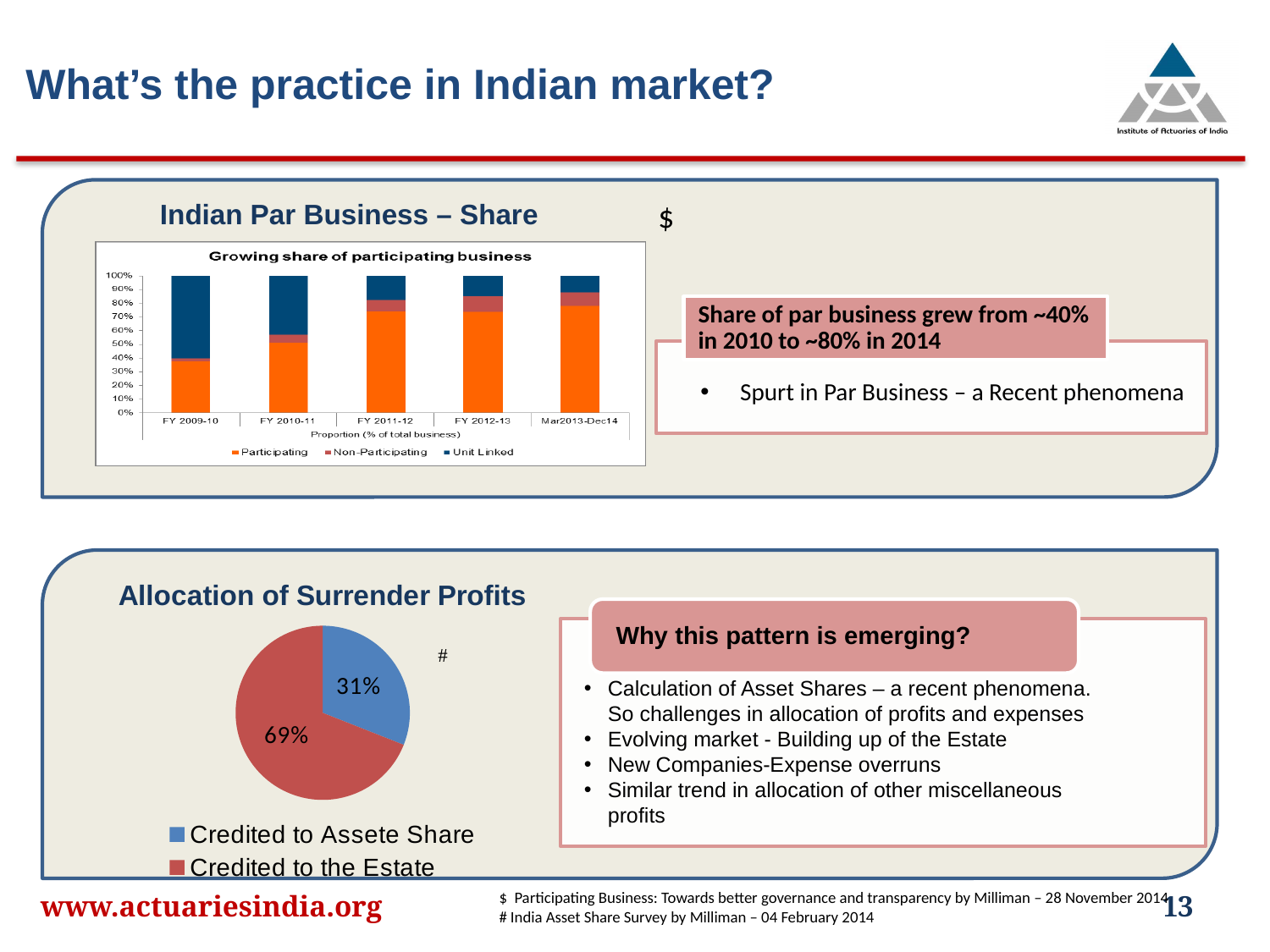
In the 'Growing share of participating business' chart, is the Participating share for FY 2009-10 greater or less than 50%? less In the 'Allocation of Surrender Profits' pie chart, what is the difference in percentage points between the Estate slice and the Asset Share slice? 38 percentage points How many periods are shown on the x axis of the 'Growing share of participating business' chart? 5 In the 'Allocation of Surrender Profits' pie chart, what share is credited to Asset Share? 31% In the 'Allocation of Surrender Profits' pie chart, what share is credited to the Estate? 69% In the 'Growing share of participating business' chart, does the Participating share rise or fall from FY 2009-10 to Mar2013-Dec14? Rise What type of chart is 'Growing share of participating business'? Stacked bar chart In the 'Growing share of participating business' chart, is the Participating share for Mar2013-Dec14 greater or less than 70%? greater In the 'Allocation of Surrender Profits' pie chart, which slice is the largest? Credited to the Estate How many slices does the 'Allocation of Surrender Profits' pie chart have? 2 How many series does the legend of the 'Growing share of participating business' chart list? 3 What type of chart is 'Allocation of Surrender Profits'? Pie chart